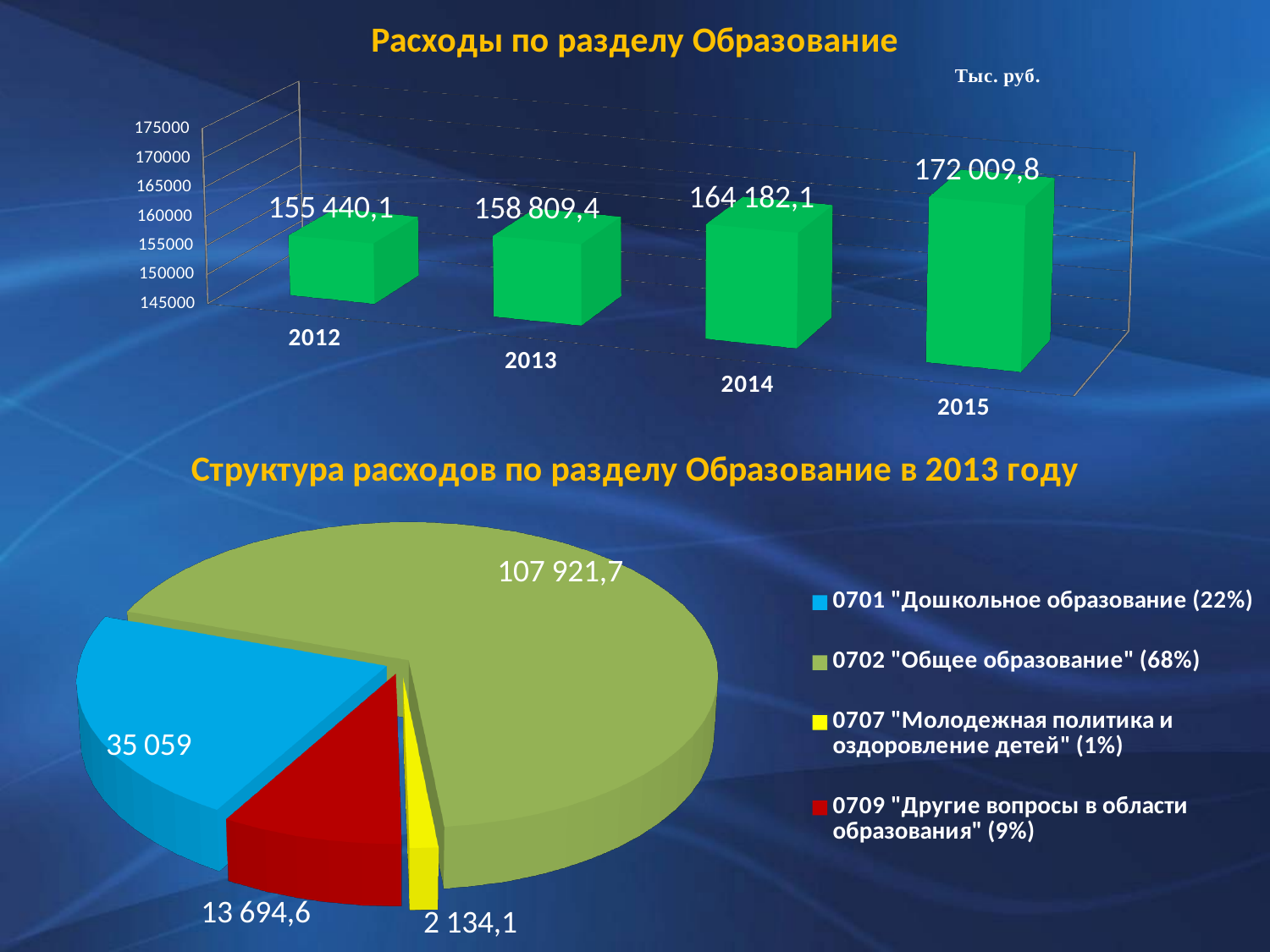
In the chart "Расходы по разделу Образование", do the values rise or fall from 2012 to 2015? rise In the pie chart "Структура расходов по разделу Образование в 2013 году", which category has the smallest slice? 0707 "Молодежная политика и оздоровление детей" In the chart "Расходы по разделу Образование", which year has the lowest value? 2012 In the chart "Расходы по разделу Образование", how many years are shown? 4 In the chart "Расходы по разделу Образование", what is the difference between the values for 2015 and 2012? 16 569,7 In the chart "Расходы по разделу Образование", what is the value for 2015? 172 009,8 What kind of chart is "Расходы по разделу Образование"? bar chart How many entries does the legend of the pie chart "Структура расходов по разделу Образование в 2013 году" list? 4 In the chart "Расходы по разделу Образование", which year has the highest value? 2015 In the pie chart "Структура расходов по разделу Образование в 2013 году", what share does 0701 "Дошкольное образование" have? 22% In the pie chart "Структура расходов по разделу Образование в 2013 году", what is the value for 0702 "Общее образование"? 107 921,7 In the chart "Расходы по разделу Образование", what is the value for 2012? 155 440,1